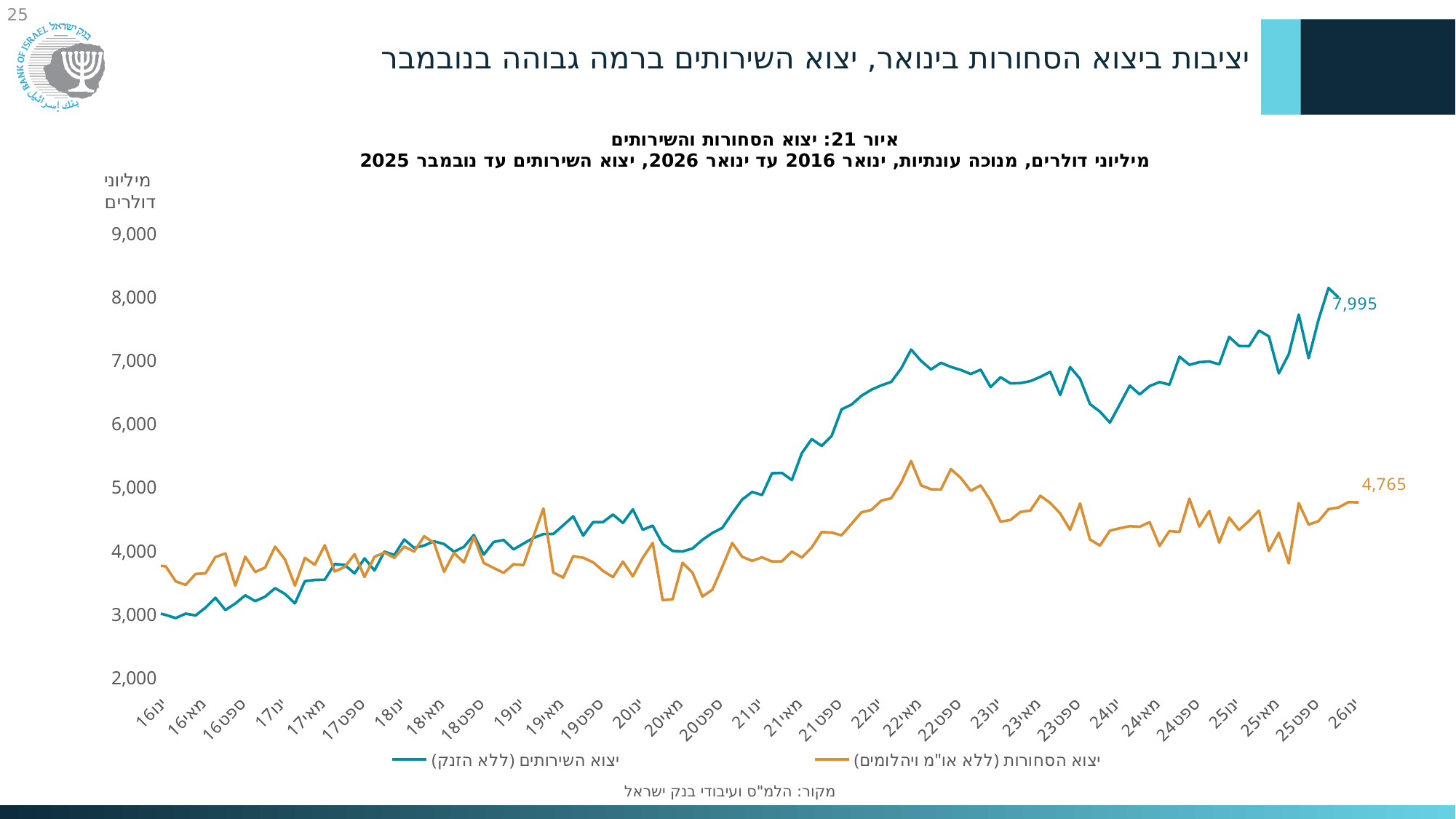
What unit is shown on the y axis of the chart? מיליוני דולרים What is the figure number given in the chart title? איור 21 Is the value of the services exports series at the end of the chart greater or less than 7,000? greater What kind of chart is shown on the slide? Line chart Is the value of the goods exports series at the end of the chart greater or less than 5,000? less What is the latest labelled value of the goods exports series (יצוא הסחורות (ללא או"מ ויהלומים))? 4,765 Does the services exports series (teal line) generally rise or fall from January 2016 to January 2026? Rise Is the value of the services exports series at the start of the chart (ינו16) greater or less than 4,000? less What is the difference between the two labelled end values, 7,995 and 4,765? 3,230 What is the latest labelled value of the services exports series (יצוא השירותים (ללא הזנק))? 7,995 How many series does the legend list? 2 Which series has the higher labelled end value: services exports or goods exports? יצוא השירותים (ללא הזנק)